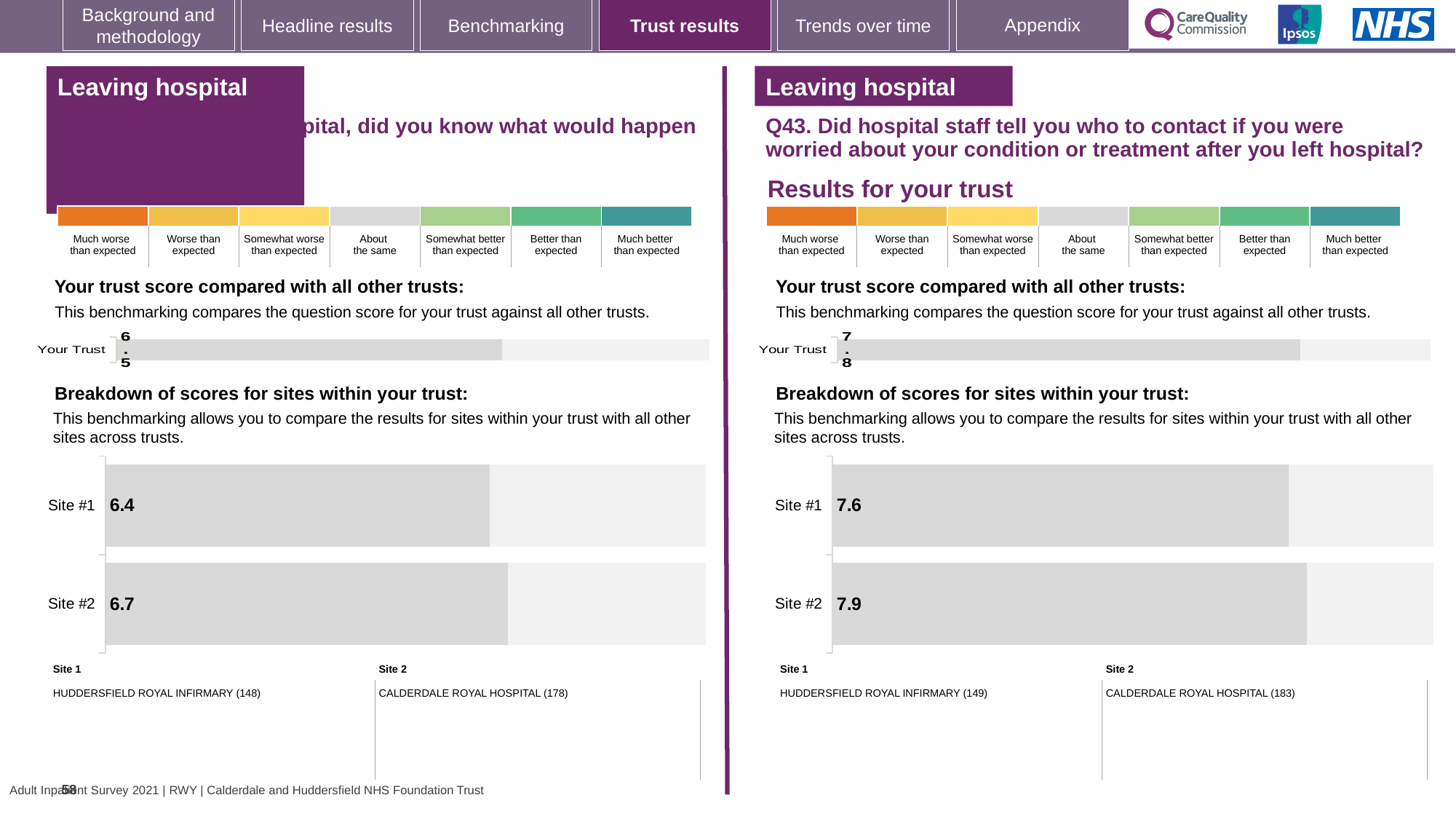
In the Q43 site breakdown chart on the right half of the slide, what is the difference between the Site #2 and Site #1 scores? 0.3 In the Q43 site breakdown chart on the right half of the slide, what is the score for Site #1? 7.6 In the 'Your trust score compared with all other trusts' chart on the left half of the slide, what is the score for Your Trust? 6.5 In the site breakdown chart on the left half of the slide, what is the difference between the Site #2 and Site #1 scores? 0.3 In the site breakdown chart on the left half of the slide, what is the score for Site #2? 6.7 In the Q43 site breakdown chart on the right half of the slide, what is the score for Site #2? 7.9 In the site breakdown chart on the left half of the slide, what is the score for Site #1? 6.4 How many sites are shown in the Q43 site breakdown chart on the right half of the slide? 2 What kind of chart is used for the site breakdown on the left half of the slide? Bar chart In the Q43 site breakdown chart on the right half of the slide, which site has the lower score? Site #1 In the site breakdown chart on the left half of the slide, which site has the higher score? Site #2 In the Q43 'Your trust score compared with all other trusts' chart on the right half of the slide, what is the score for Your Trust? 7.8